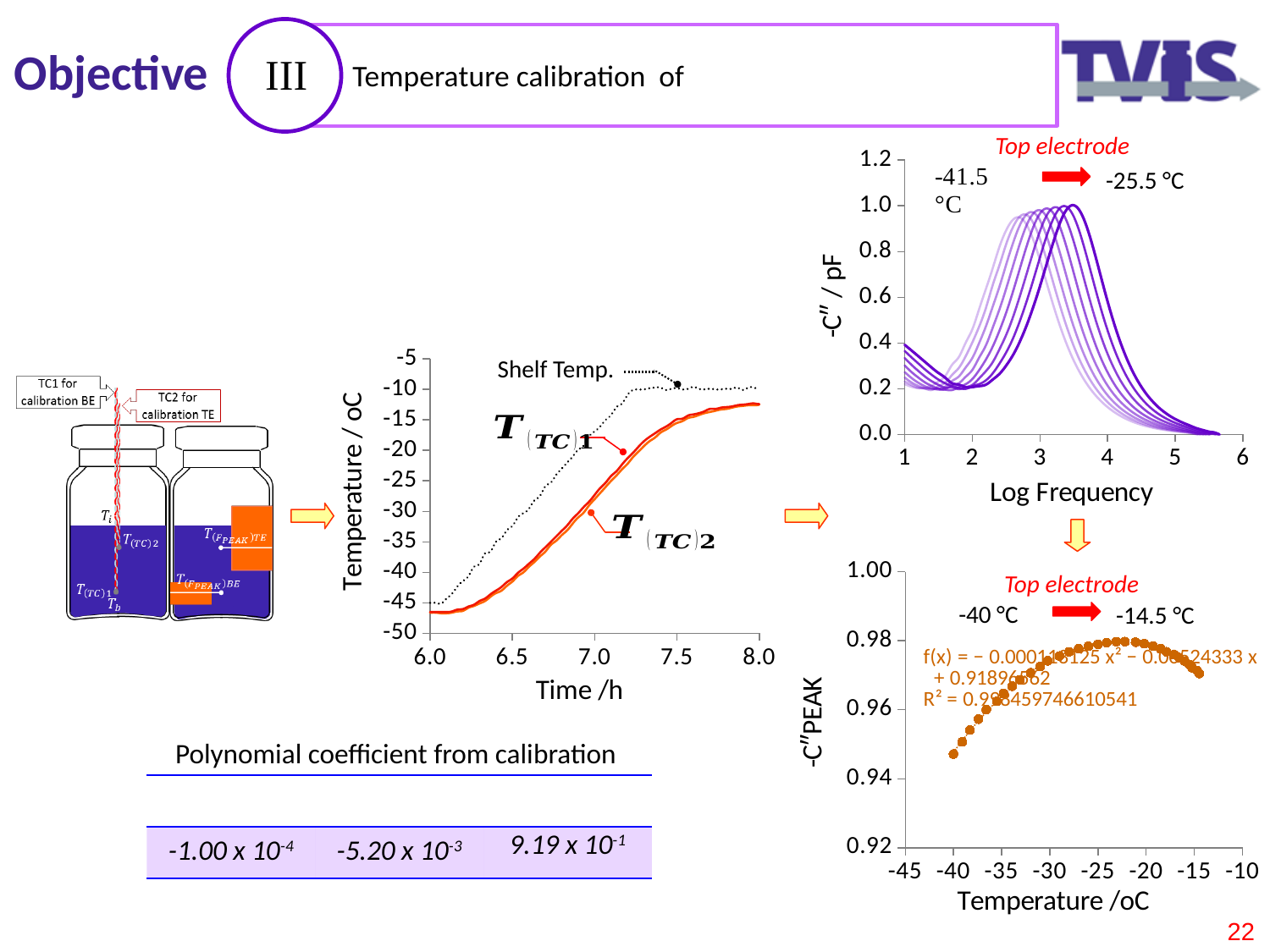
In the chart with the x axis labelled 'Log Frequency', are the curve values at log frequency 5 greater or less than 0.2? less In the chart with the x axis labelled 'Time /h', is the T(TC)2 value at 6.0 h greater or less than -40? less In the chart with the x axis labelled 'Temperature /oC', is the -C''PEAK value at -15 °C greater or less than 0.96? greater In the chart with the x axis labelled 'Time /h', how many series are plotted? 3 What type of chart is the chart with the x axis labelled 'Time /h'? line chart In the chart with the x axis labelled 'Time /h', do the T(TC)1 and T(TC)2 values rise or fall as time increases? rise In the chart with the x axis labelled 'Log Frequency', what is the maximum value reached by the curves on the -C'' / pF axis? 1.0 In the chart with the x axis labelled 'Temperature /oC', what temperature range is annotated for the Top electrode? -40 °C to -14.5 °C What type of chart is the chart with the x axis labelled 'Temperature /oC'? scatter chart In the chart with the x axis labelled 'Log Frequency', what temperature range is annotated for the Top electrode? -41.5 °C to -25.5 °C